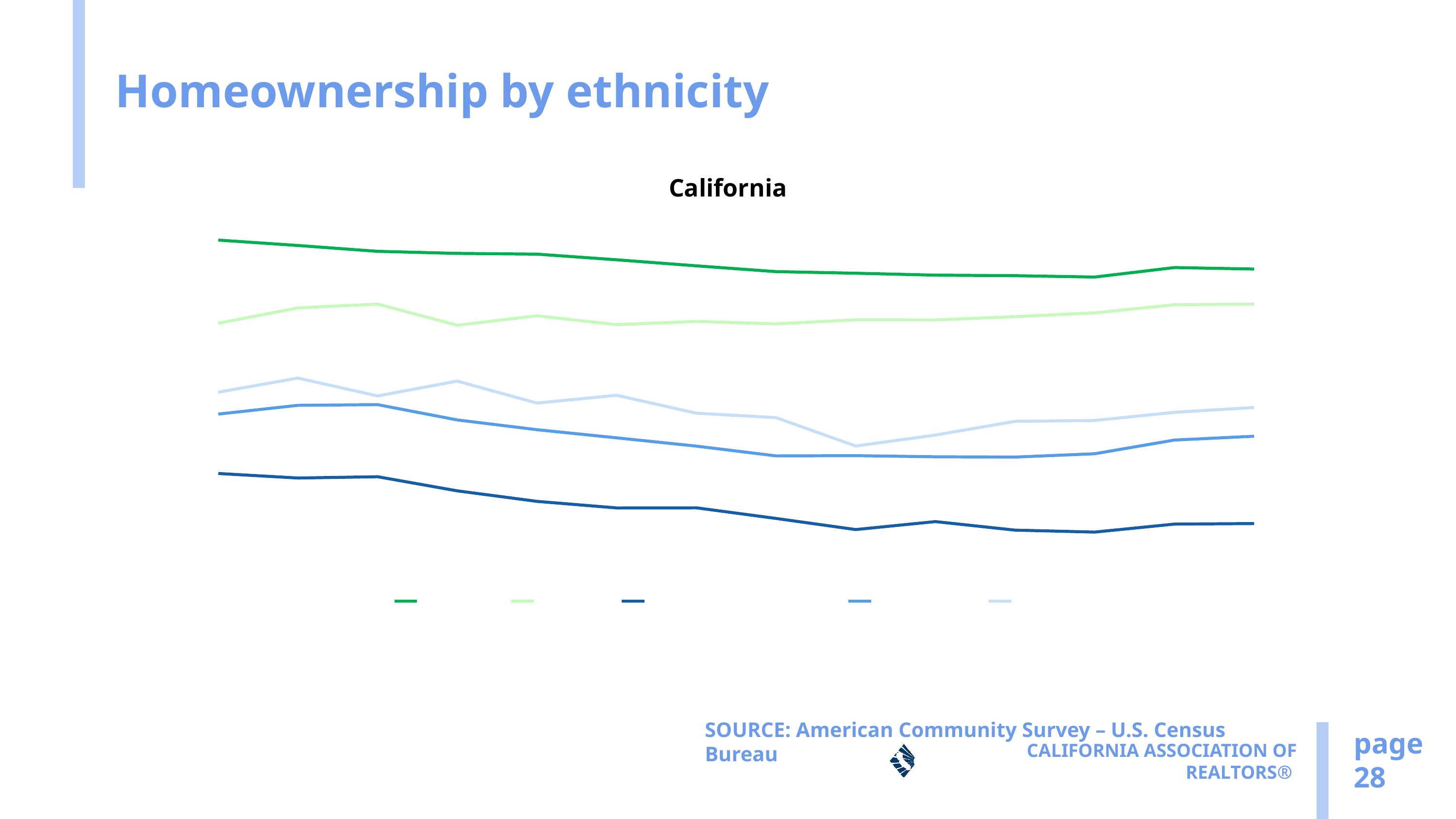
What is the title of the chart? California What kind of chart is shown on the slide? line chart What colour is the line that stays highest across the chart? dark green Does the lowest (dark blue) line generally rise or fall from left to right? fall How many lines are plotted on the chart? 5 How many series does the legend list? 5 Does the topmost (dark green) line generally rise or fall from left to right? fall